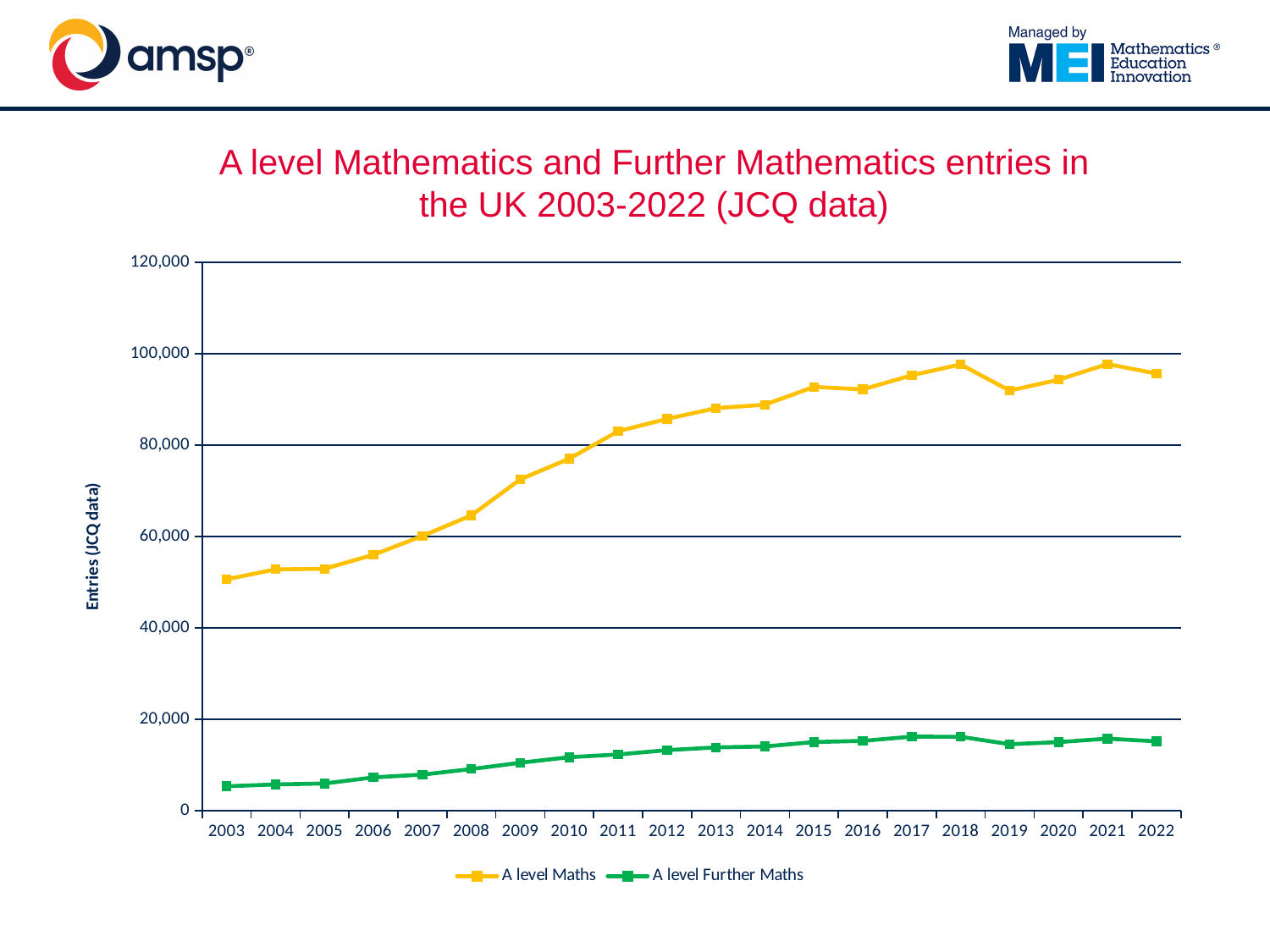
Is the value for A level Maths in 2018 greater or less than 100,000? less What kind of chart is shown on the slide? Line chart Do the A level Maths entries rise or fall between 2003 and 2011? rise How many series does the legend list? 2 How many years are plotted along the x axis? 20 Which is larger for A level Maths: the value in 2018 or the value in 2019? 2018 Which is larger for A level Further Maths: the value in 2018 or the value in 2019? 2018 What is the label on the vertical axis? Entries (JCQ data) Which year has the lowest value for A level Further Maths? 2003 Which year has the lowest value for A level Maths? 2003 Is the value for A level Further Maths in 2022 greater or less than 20,000? less Is the value for A level Maths in 2011 greater or less than 80,000? greater